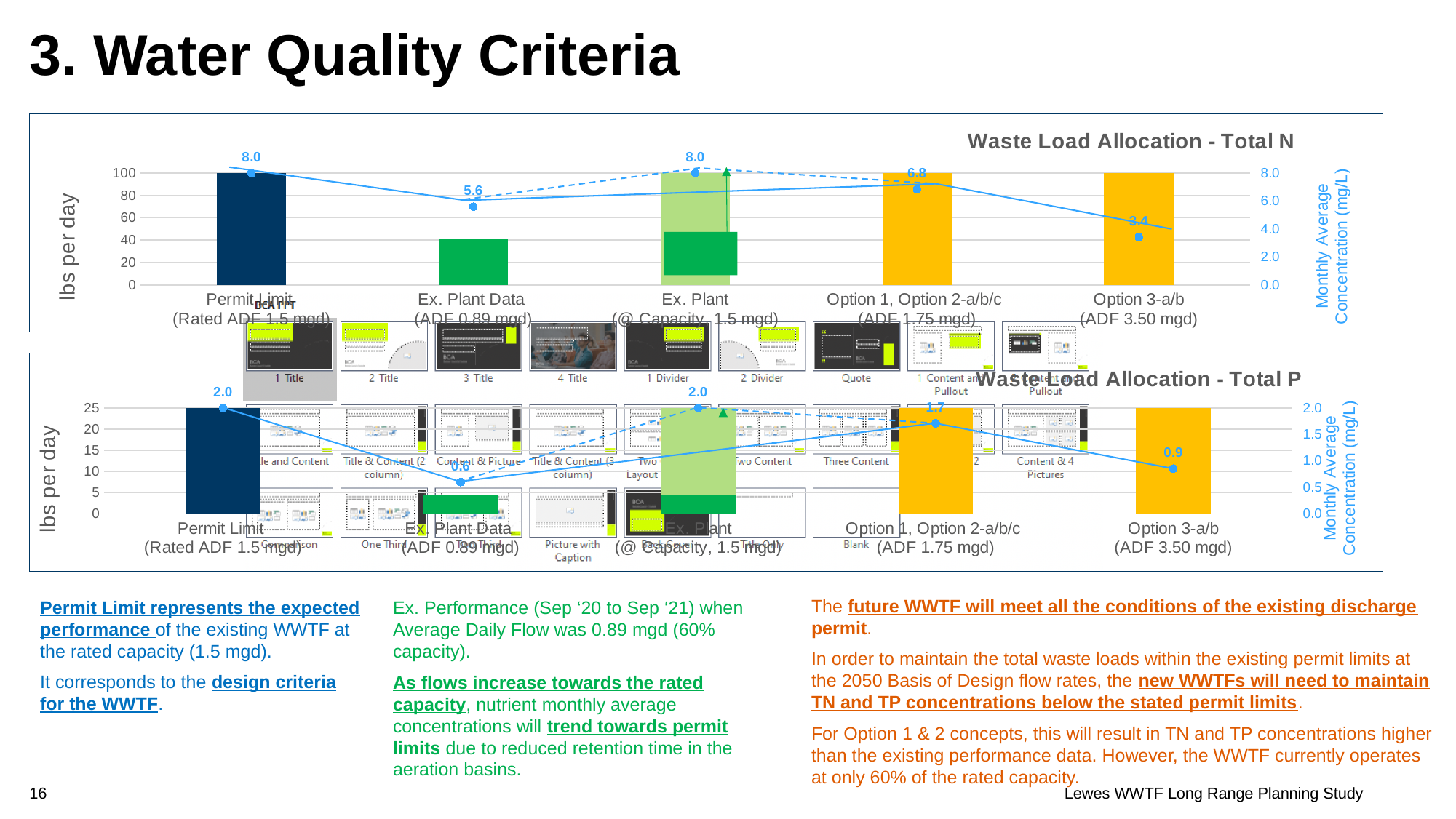
In the Waste Load Allocation - Total N chart, is the lbs per day bar for Permit Limit (Rated ADF 1.5 mgd) greater or less than 80? greater In the Waste Load Allocation - Total P chart, is the lbs per day bar for Ex. Plant Data (ADF 0.89 mgd) greater or less than 10? less In the Waste Load Allocation - Total N chart, what is the monthly average concentration labelled for Option 3-a/b (ADF 3.50 mgd)? 3.4 In the Waste Load Allocation - Total N chart, what is the difference between the labelled concentration for Permit Limit (8.0) and for Option 3-a/b (3.4)? 4.6 In the Waste Load Allocation - Total P chart, what is the monthly average concentration labelled for Option 1, Option 2-a/b/c (ADF 1.75 mgd)? 1.7 In the Waste Load Allocation - Total N chart, is the lbs per day bar for Ex. Plant Data (ADF 0.89 mgd) greater or less than 60? less How many categories are shown on the x axis of the Waste Load Allocation - Total P chart? 5 What is the label of the left vertical axis on the Waste Load Allocation - Total N chart? lbs per day In the Waste Load Allocation - Total P chart, what is the difference between the labelled concentration for Permit Limit (2.0) and for Ex. Plant Data (0.6)? 1.4 In the Waste Load Allocation - Total N chart, which category has the lowest labelled monthly average concentration? Option 3-a/b (ADF 3.50 mgd) In the Waste Load Allocation - Total N chart, what is the monthly average concentration labelled for Ex. Plant Data (ADF 0.89 mgd)? 5.6 In the Waste Load Allocation - Total P chart, which category has the lowest labelled monthly average concentration? Ex. Plant Data (ADF 0.89 mgd)